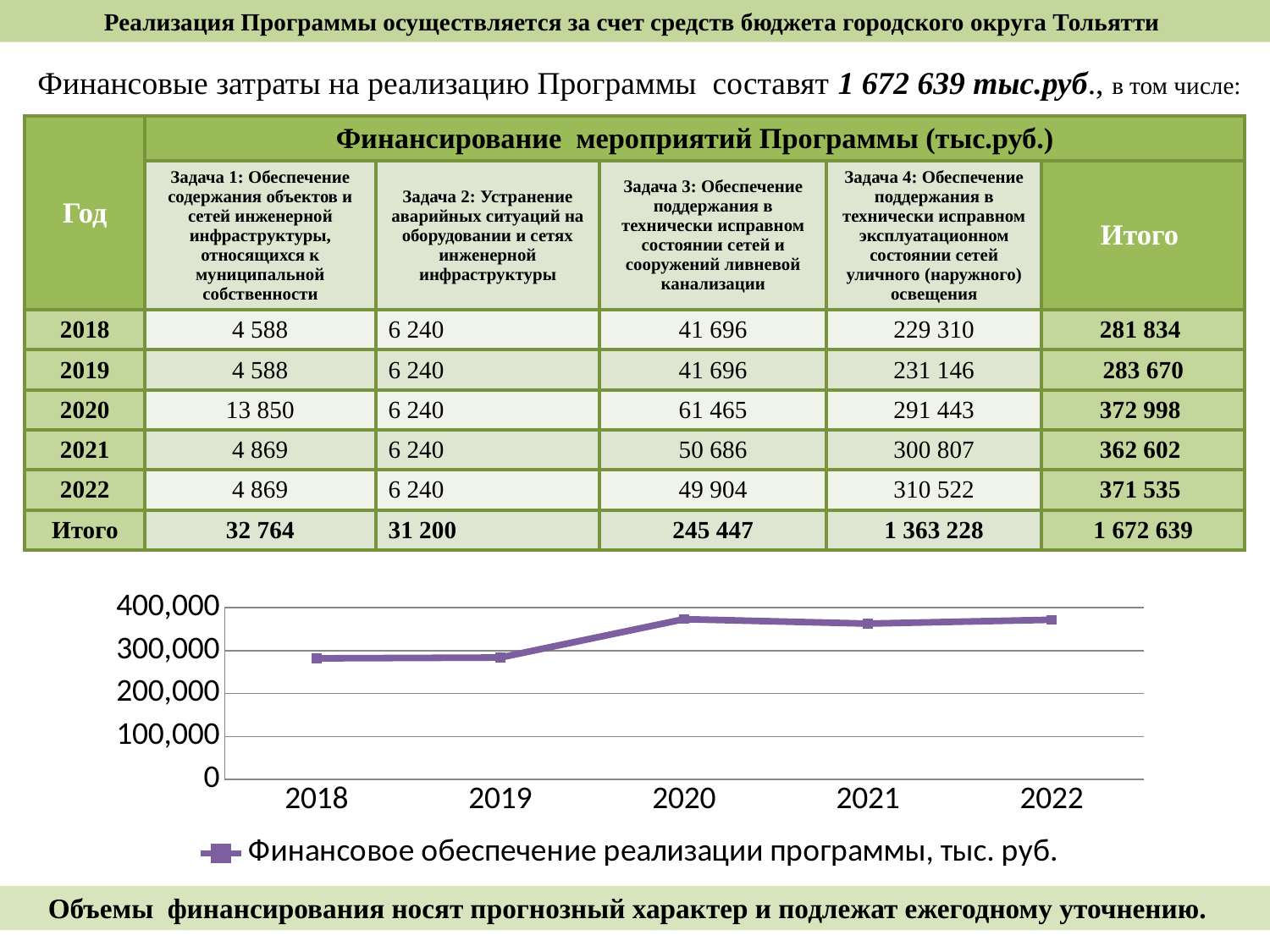
Is the value for 2020 greater or less than 300,000? greater What kind of chart is shown on the slide? line chart Is the value for 2018 greater or less than 300,000? less Is the value for 2019 greater or less than 200,000? greater Does the plotted value rise or fall between 2019 and 2020? rise How many years are plotted on the x axis of the chart? 5 What colour is the line in the chart? purple What is the legend entry of the series plotted in the chart? Финансовое обеспечение реализации программы, тыс. руб. How many series does the chart legend list? 1 Which year has the larger value, 2018 or 2020? 2020 Which year has the larger value, 2019 or 2021? 2021